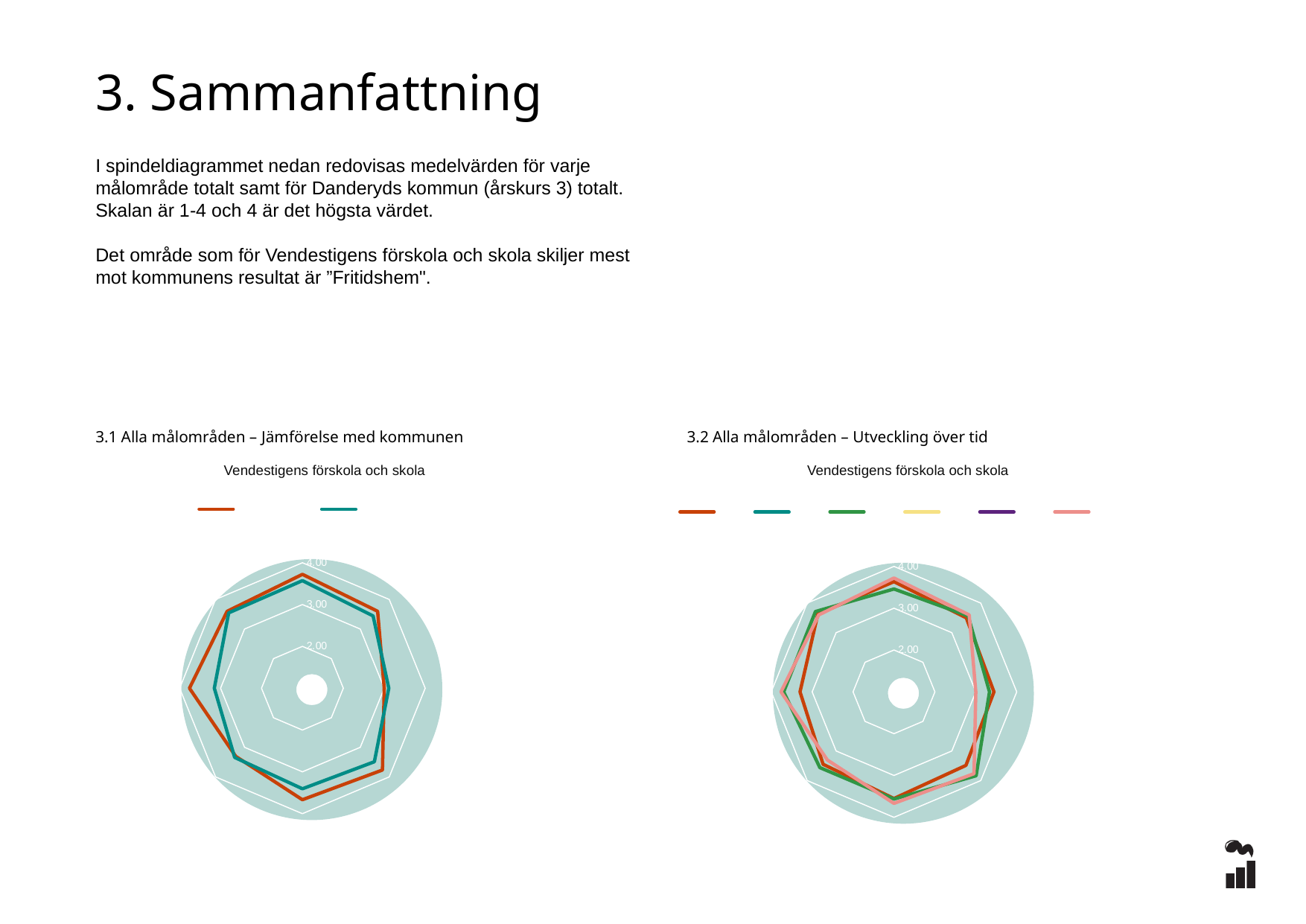
What kind of chart is the left chart, 3.1 Alla målområden – Jämförelse med kommunen? Radar chart On the left chart (3.1 Jämförelse med kommunen), is the lowest plotted value greater or less than 2.00? greater On the right chart (3.2 Utveckling över tid), is the lowest plotted value greater or less than 2.00? greater What kind of chart is the right chart, 3.2 Alla målområden – Utveckling över tid? Radar chart How many series does the legend of the right chart (3.2 Utveckling över tid) list? 6 What is the title shown above the left chart (3.1 Jämförelse med kommunen)? Vendestigens förskola och skola How many axes (categories) does the left chart (3.1 Jämförelse med kommunen) have? 8 How many series does the legend of the left chart (3.1 Jämförelse med kommunen) list? 2 How many axes (categories) does the right chart (3.2 Utveckling över tid) have? 8 What is the highest value labelled on the scale rings of the right chart (3.2 Utveckling över tid)? 4.00